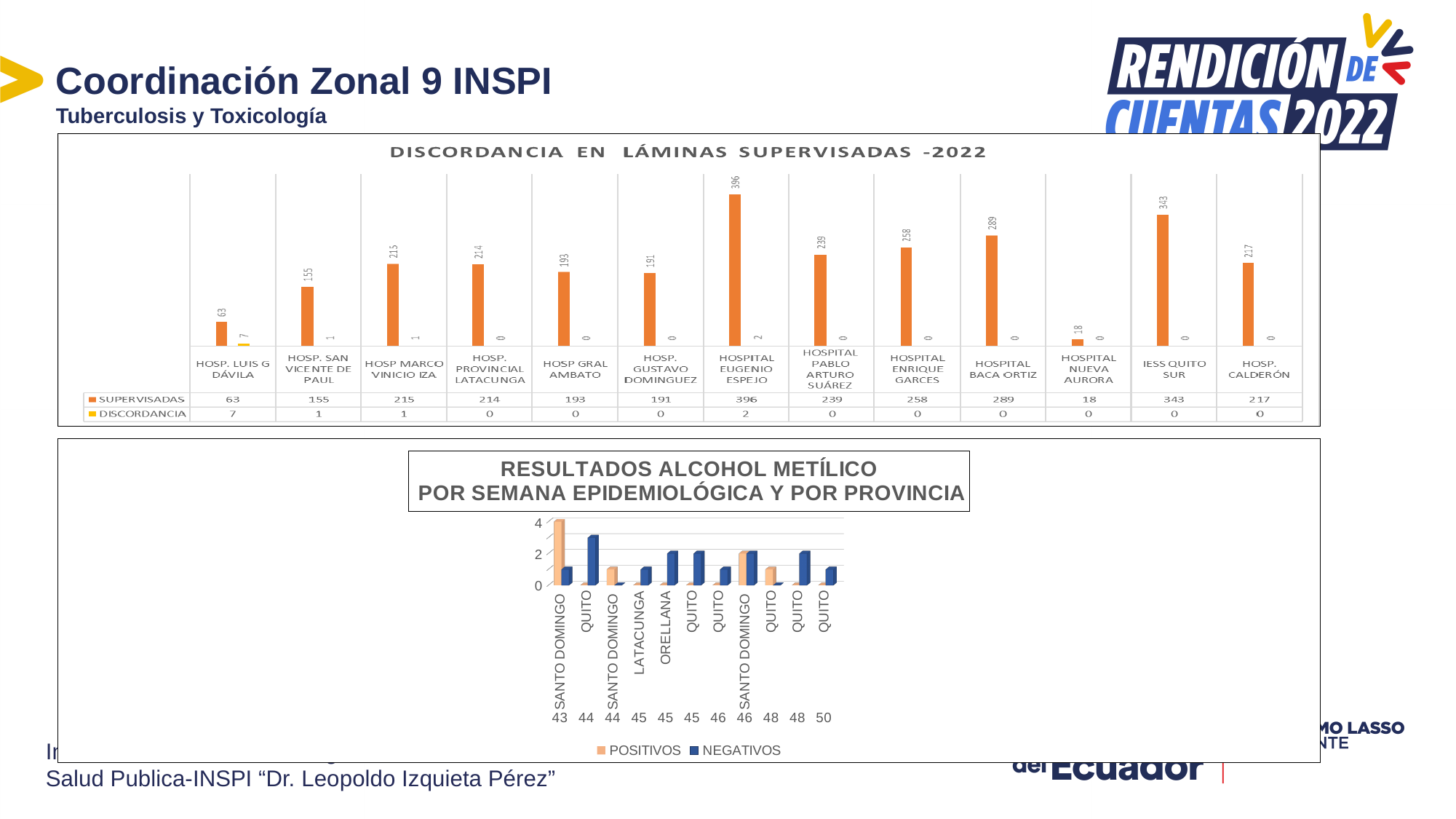
In the chart titled 'DISCORDANCIA EN LÁMINAS SUPERVISADAS -2022', how many series does the legend list? 2 In the chart titled 'DISCORDANCIA EN LÁMINAS SUPERVISADAS -2022', which hospital has the lowest SUPERVISADAS value? HOSPITAL NUEVA AURORA In the chart titled 'DISCORDANCIA EN LÁMINAS SUPERVISADAS -2022', what is the DISCORDANCIA value for HOSPITAL EUGENIO ESPEJO? 2 What kind of chart is the one titled 'RESULTADOS ALCOHOL METÍLICO POR SEMANA EPIDEMIOLÓGICA Y POR PROVINCIA'? bar chart In the chart titled 'RESULTADOS ALCOHOL METÍLICO POR SEMANA EPIDEMIOLÓGICA Y POR PROVINCIA', is the POSITIVOS value for SANTO DOMINGO in week 43 greater or less than 2? greater In the chart titled 'DISCORDANCIA EN LÁMINAS SUPERVISADAS -2022', what is the SUPERVISADAS value for HOSPITAL EUGENIO ESPEJO? 396 In the chart titled 'DISCORDANCIA EN LÁMINAS SUPERVISADAS -2022', what is the DISCORDANCIA value for HOSP. LUIS G DÁVILA? 7 In the chart titled 'RESULTADOS ALCOHOL METÍLICO POR SEMANA EPIDEMIOLÓGICA Y POR PROVINCIA', how many series does the legend list? 2 In the chart titled 'DISCORDANCIA EN LÁMINAS SUPERVISADAS -2022', what is the difference between the SUPERVISADAS values for IESS QUITO SUR and HOSPITAL BACA ORTIZ? 54 In the chart titled 'DISCORDANCIA EN LÁMINAS SUPERVISADAS -2022', which has a larger SUPERVISADAS value, HOSP. SAN VICENTE DE PAUL or HOSP GRAL AMBATO? HOSP GRAL AMBATO In the chart titled 'DISCORDANCIA EN LÁMINAS SUPERVISADAS -2022', how many hospitals are shown? 13 In the chart titled 'DISCORDANCIA EN LÁMINAS SUPERVISADAS -2022', which hospital has the highest SUPERVISADAS value? HOSPITAL EUGENIO ESPEJO